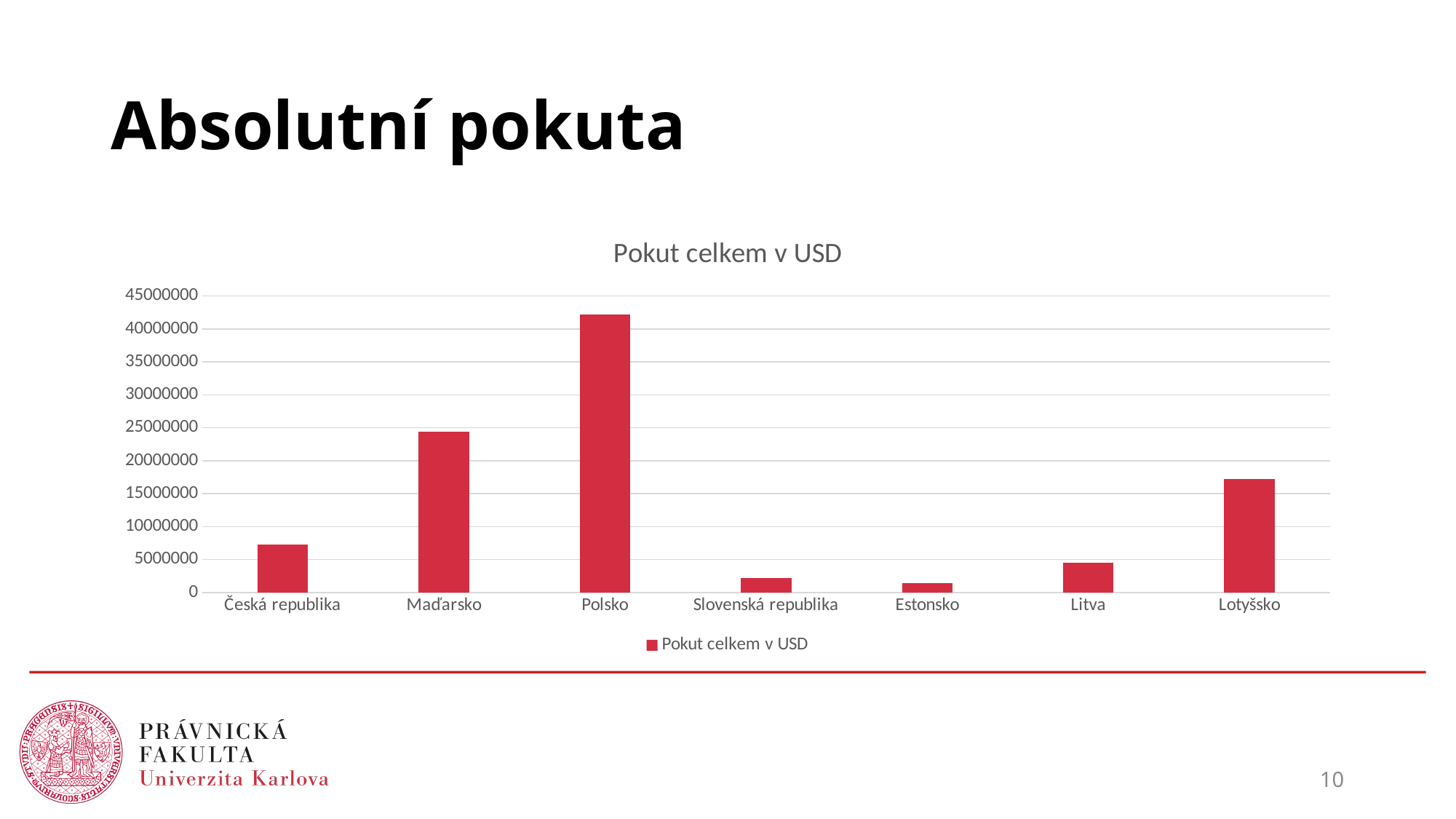
Which has a larger value, Maďarsko or Lotyšsko? Maďarsko How many series does the legend list? 1 Which has a larger value, Česká republika or Litva? Česká republika What kind of chart is shown on the slide? bar chart Is the value for Lotyšsko greater or less than 15000000? greater Which country has the lowest total fine in the chart? Estonsko Is the value for Polsko greater or less than 40000000? greater Is the value for Litva greater or less than 5000000? less Which country has the highest total fine in the chart? Polsko What is the title of the chart? Pokut celkem v USD How many countries are shown on the x axis of the chart? 7